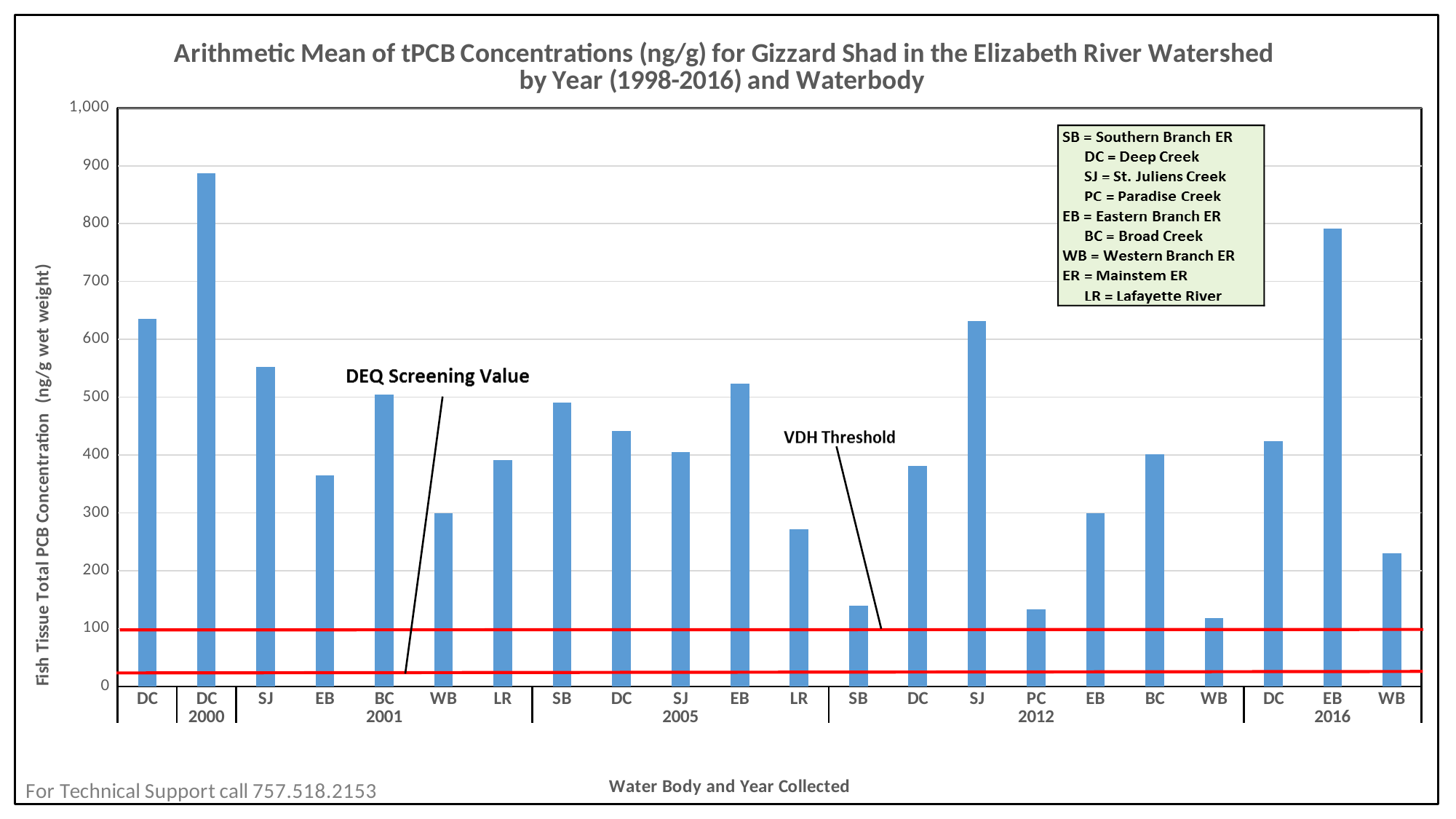
How many bars are plotted in the chart? 22 Is the value for SJ in 2012 greater or less than 600? greater Is the value for EB in 2001 greater or less than 400? less What kind of chart is shown on the slide? bar chart Is the value for DC in 2000 greater or less than 800? greater According to the key on the chart, what does the abbreviation LR stand for? Lafayette River Which is larger, the value for EB in 2016 or the value for SJ in 2012? EB 2016 Which is larger, the value for SB in 2005 or the value for LR in 2005? SB 2005 Which bar has the lowest tPCB concentration? WB 2012 Which bar has the highest tPCB concentration? DC 2000